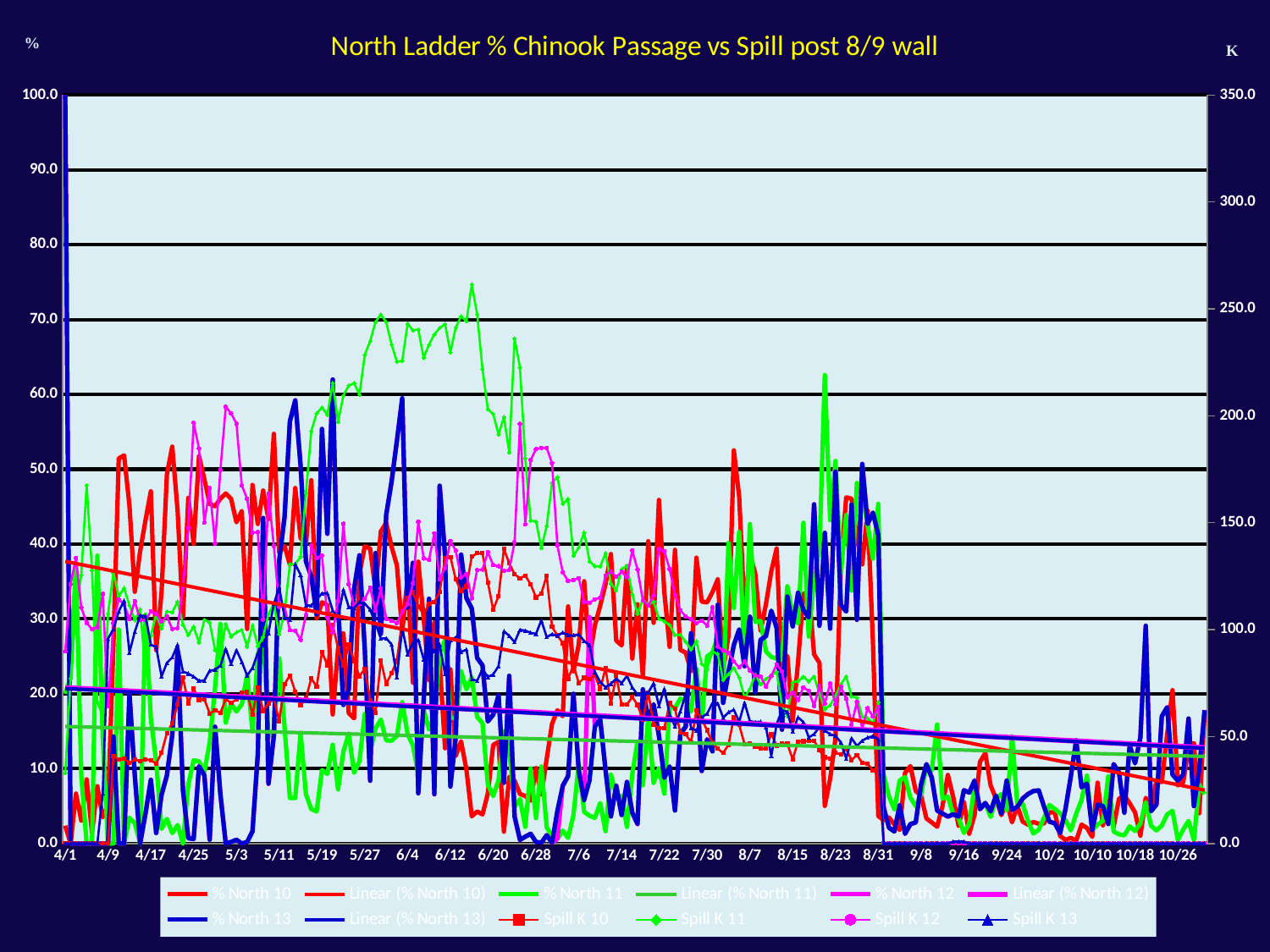
How many series does the legend list? 12 Which trend line starts higher at 4/1: Linear (% North 10) or Linear (% North 11)? Linear (% North 10) Does the Linear (% North 10) trend line rise or fall from left to right across the x axis? fall What is the maximum value shown on the right-hand (K) axis? 350.0 How many date labels are shown along the x axis? 27 What kind of chart is shown on the slide? line chart Is the value of the Linear (% North 11) trend line at 4/1 greater or less than 20.0? less Is the value of the Linear (% North 10) trend line at the right end of the chart greater or less than 10.0? less Does the Linear (% North 13) trend line rise or fall from 4/1 to 10/26? fall What is the title of the chart? North Ladder % Chinook Passage vs Spill post 8/9 wall Is the value of the Linear (% North 10) trend line at 4/1 greater or less than 30.0? greater